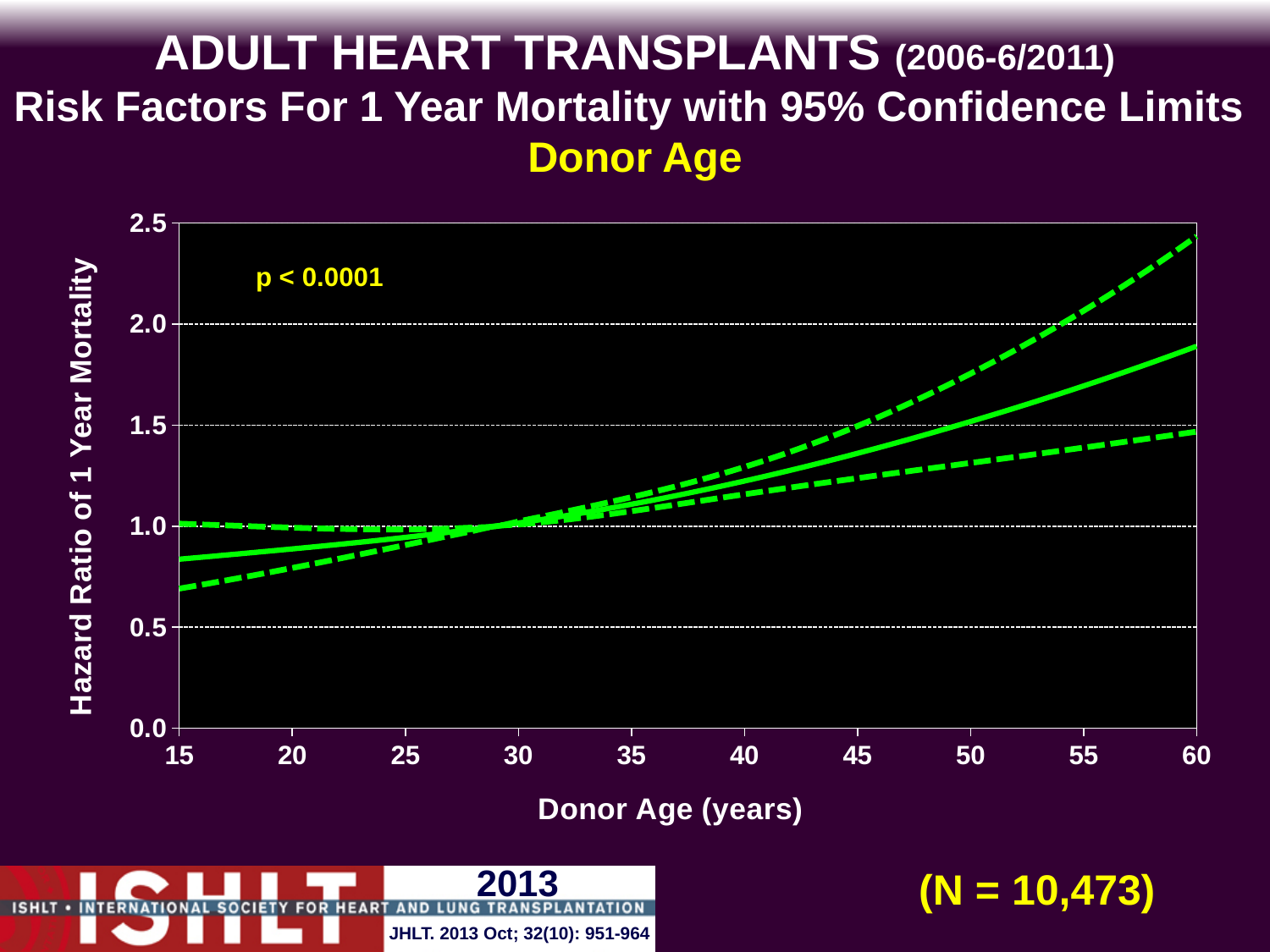
Is the lower 95% confidence limit at donor age 60 greater or less than 1.0? greater What p-value is printed on the chart? p < 0.0001 Is the hazard ratio (solid line) larger at donor age 60 or at donor age 15? donor age 60 What is the label of the x axis? Donor Age (years) How many lines are plotted on the chart? 3 Is the upper 95% confidence limit at donor age 15 greater or less than 1.5? less Does the hazard ratio of 1 year mortality rise or fall as donor age increases from 15 to 60 years? rise Is the upper 95% confidence limit at donor age 60 greater or less than 2.0? greater What kind of chart is shown on the slide? line chart